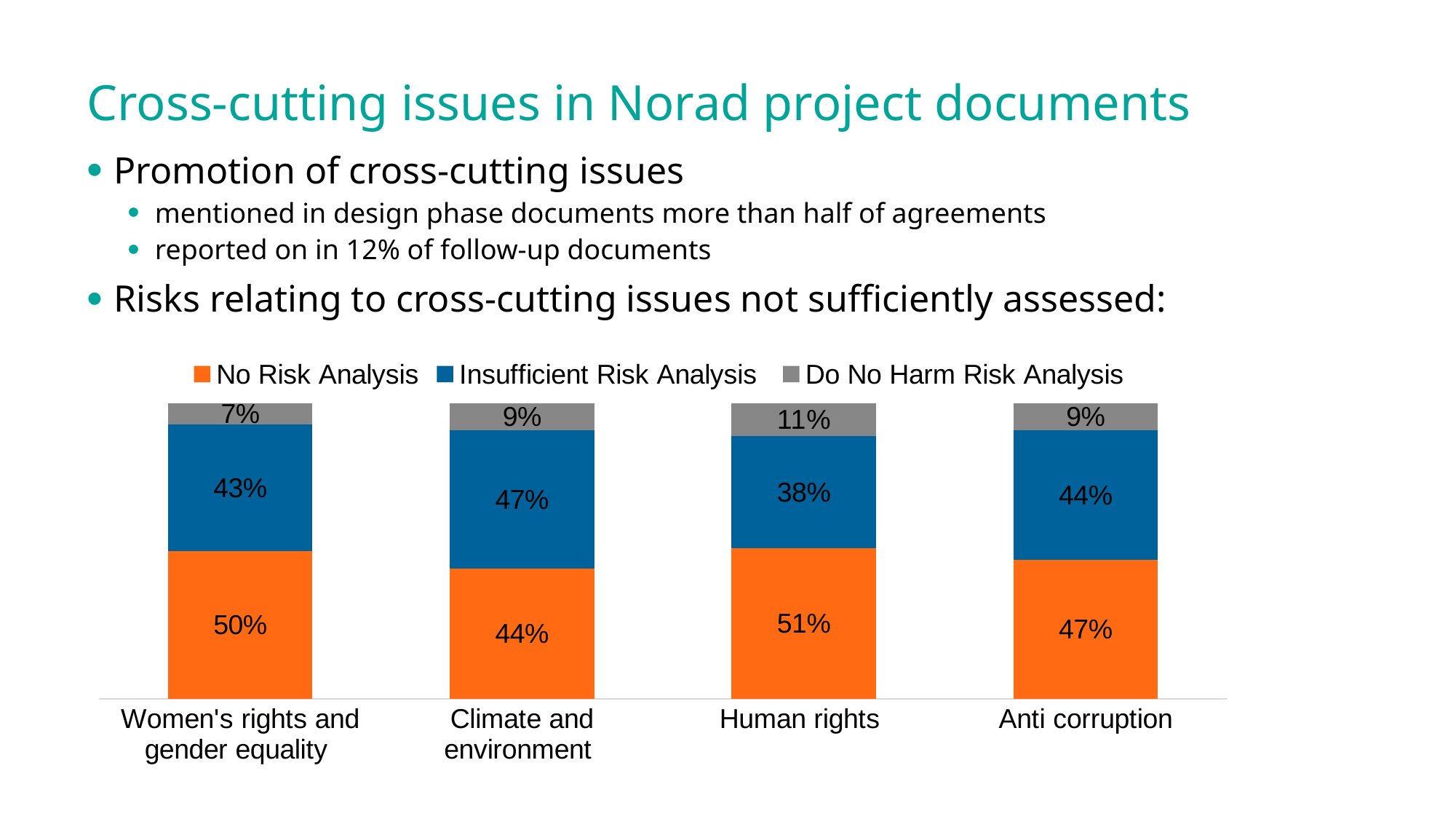
What is the Do No Harm Risk Analysis value for Women's rights and gender equality? 7% How many series does the legend list? 3 Which category has the lowest Insufficient Risk Analysis share? Human rights What is the No Risk Analysis value for Anti corruption? 47% What percentage of Human rights agreements had No Risk Analysis? 51% What is the Insufficient Risk Analysis value for Climate and environment? 47% How many categories are shown on the x axis? 4 Which category has the highest Do No Harm Risk Analysis share? Human rights What is the difference between the No Risk Analysis values for Human rights and Climate and environment? 7% Which is larger: the Insufficient Risk Analysis value for Anti corruption or for Women's rights and gender equality? Anti corruption What kind of chart is shown on the slide? Stacked bar chart Which colour represents Insufficient Risk Analysis in the chart? Blue